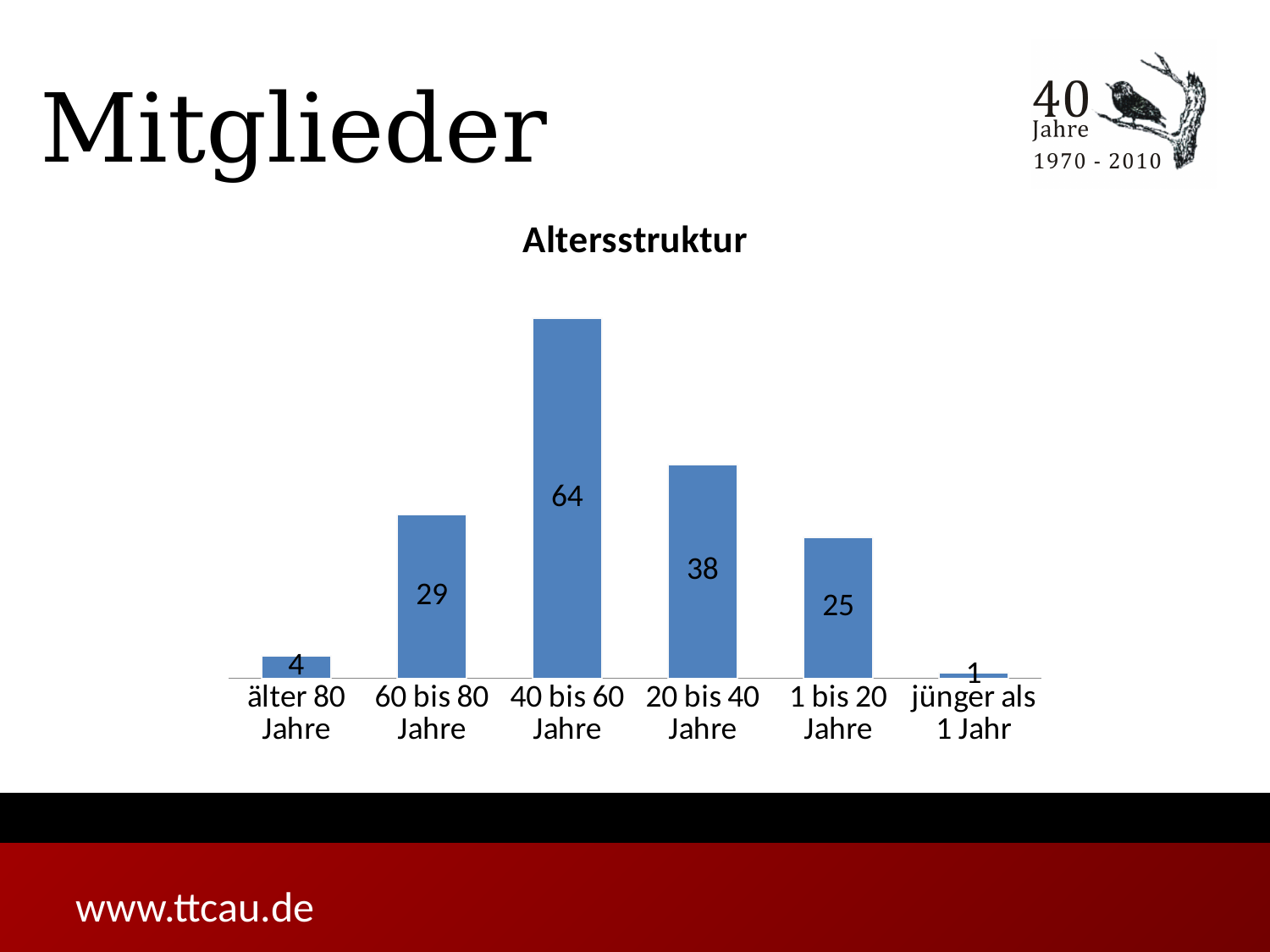
What kind of chart is shown on the slide? bar chart What is the value for the "1 bis 20 Jahre" category? 25 What is the value for the "jünger als 1 Jahr" category? 1 How many categories are shown in the chart? 6 Which is larger, the value for "60 bis 80 Jahre" or the value for "20 bis 40 Jahre"? 20 bis 40 Jahre What is the difference between the values for "40 bis 60 Jahre" and "20 bis 40 Jahre"? 26 What is the difference between the values for "60 bis 80 Jahre" and "1 bis 20 Jahre"? 4 Which category has the highest value? 40 bis 60 Jahre Which category has the lowest value? jünger als 1 Jahr What is the title of the chart? Altersstruktur What is the value for the "40 bis 60 Jahre" category? 64 What is the value for the "älter 80 Jahre" category? 4